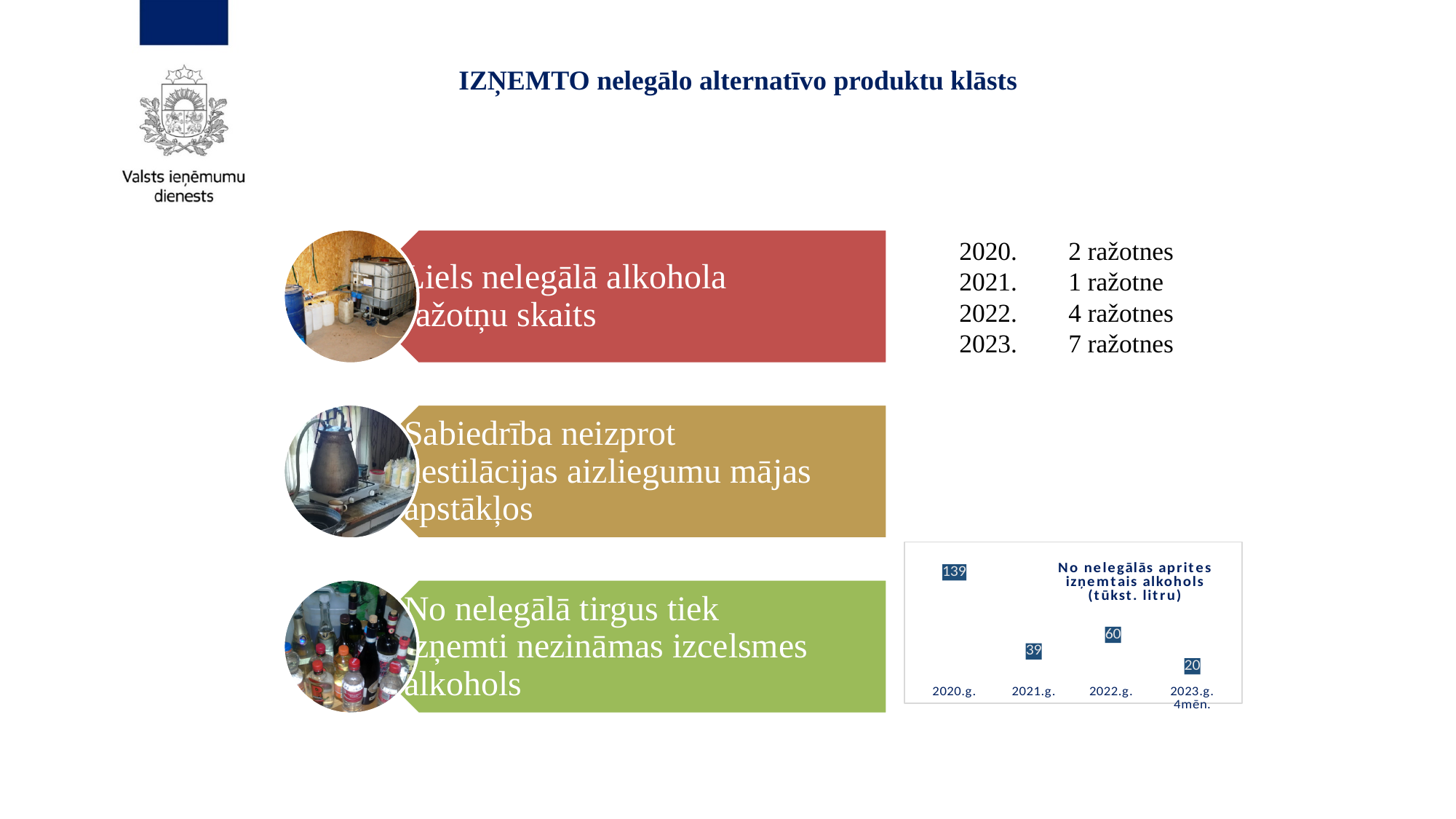
In the chart "No nelegālās aprites izņemtais alkohols (tūkst. litru)", what is the difference between the values for 2020.g. and 2021.g.? 100 In what unit are the values in the chart "No nelegālās aprites izņemtais alkohols" given? tūkst. litru What is the value for 2021.g. in the chart "No nelegālās aprites izņemtais alkohols (tūkst. litru)"? 39 Which year has the highest value in the chart "No nelegālās aprites izņemtais alkohols (tūkst. litru)"? 2020.g. In the chart "No nelegālās aprites izņemtais alkohols (tūkst. litru)", what is the difference between the values for 2022.g. and 2023.g. 4mēn.? 40 What is the value for 2023.g. 4mēn. in the chart "No nelegālās aprites izņemtais alkohols (tūkst. litru)"? 20 What is the value for 2020.g. in the chart "No nelegālās aprites izņemtais alkohols (tūkst. litru)"? 139 What is the title of the chart on the slide? No nelegālās aprites izņemtais alkohols (tūkst. litru) How many categories are shown in the chart "No nelegālās aprites izņemtais alkohols (tūkst. litru)"? 4 In the chart "No nelegālās aprites izņemtais alkohols (tūkst. litru)", which is larger, the value for 2021.g. or 2022.g.? 2022.g. What is the value for 2022.g. in the chart "No nelegālās aprites izņemtais alkohols (tūkst. litru)"? 60 Which category has the lowest value in the chart "No nelegālās aprites izņemtais alkohols (tūkst. litru)"? 2023.g. 4mēn.